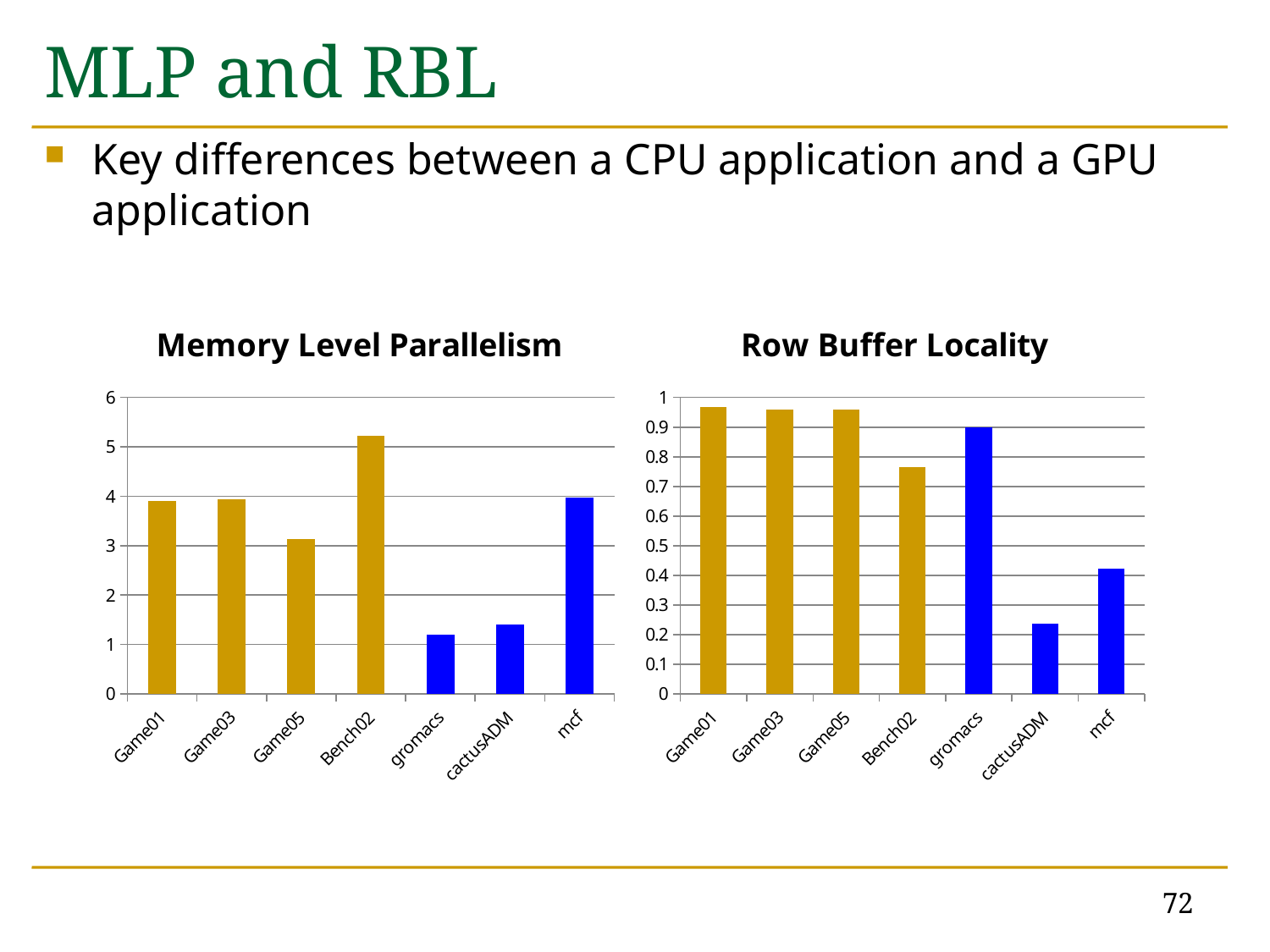
What type of chart is the Memory Level Parallelism chart? bar chart In the Row Buffer Locality chart, which category has the lowest value? cactusADM In the Memory Level Parallelism chart, is the value for Bench02 greater or less than 5? greater In the Row Buffer Locality chart, which is larger, the value for gromacs or the value for mcf? gromacs In the Memory Level Parallelism chart, which is larger, the value for Bench02 or the value for Game05? Bench02 In the Row Buffer Locality chart, is the value for gromacs greater or less than 0.8? greater In the Memory Level Parallelism chart, is the value for Game05 greater or less than 3? greater How many categories are shown on the x axis of the Row Buffer Locality chart? 7 In the Memory Level Parallelism chart, which category has the highest value? Bench02 What is the title of the chart on the right side of the slide? Row Buffer Locality